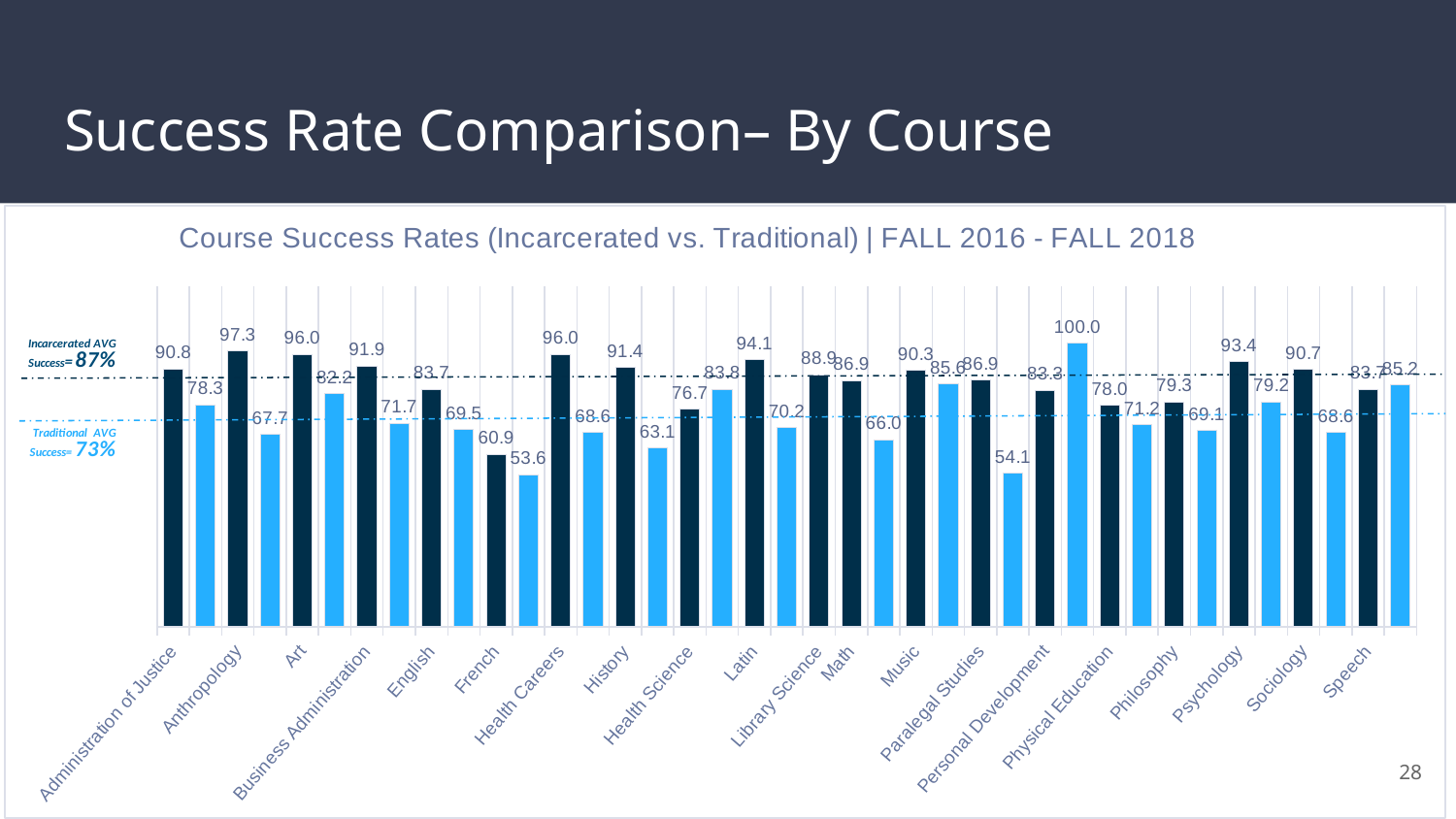
What is the incarcerated (dark bar) success rate for Anthropology? 97.3 For Anthropology, what is the difference between the dark bar (97.3) and the light blue bar (67.7)? 29.6 Which course has the highest value of any bar on the chart? Personal Development How many courses are listed along the x axis of the chart? 20 What is the traditional (light blue bar) success rate for French? 53.6 What is the incarcerated (dark bar) success rate for Psychology? 93.4 For Music, what is the difference between the dark bar (90.3) and the light blue bar (85.6)? 4.7 Which course has the lowest incarcerated (dark bar) success rate? French For Health Science, which is larger: the dark (incarcerated) bar or the light blue (traditional) bar? the light blue (traditional) bar What is the title of the chart? Course Success Rates (Incarcerated vs. Traditional) | FALL 2016 - FALL 2018 What Incarcerated AVG Success value is annotated on the chart? 87% What type of chart is shown on the slide? bar chart